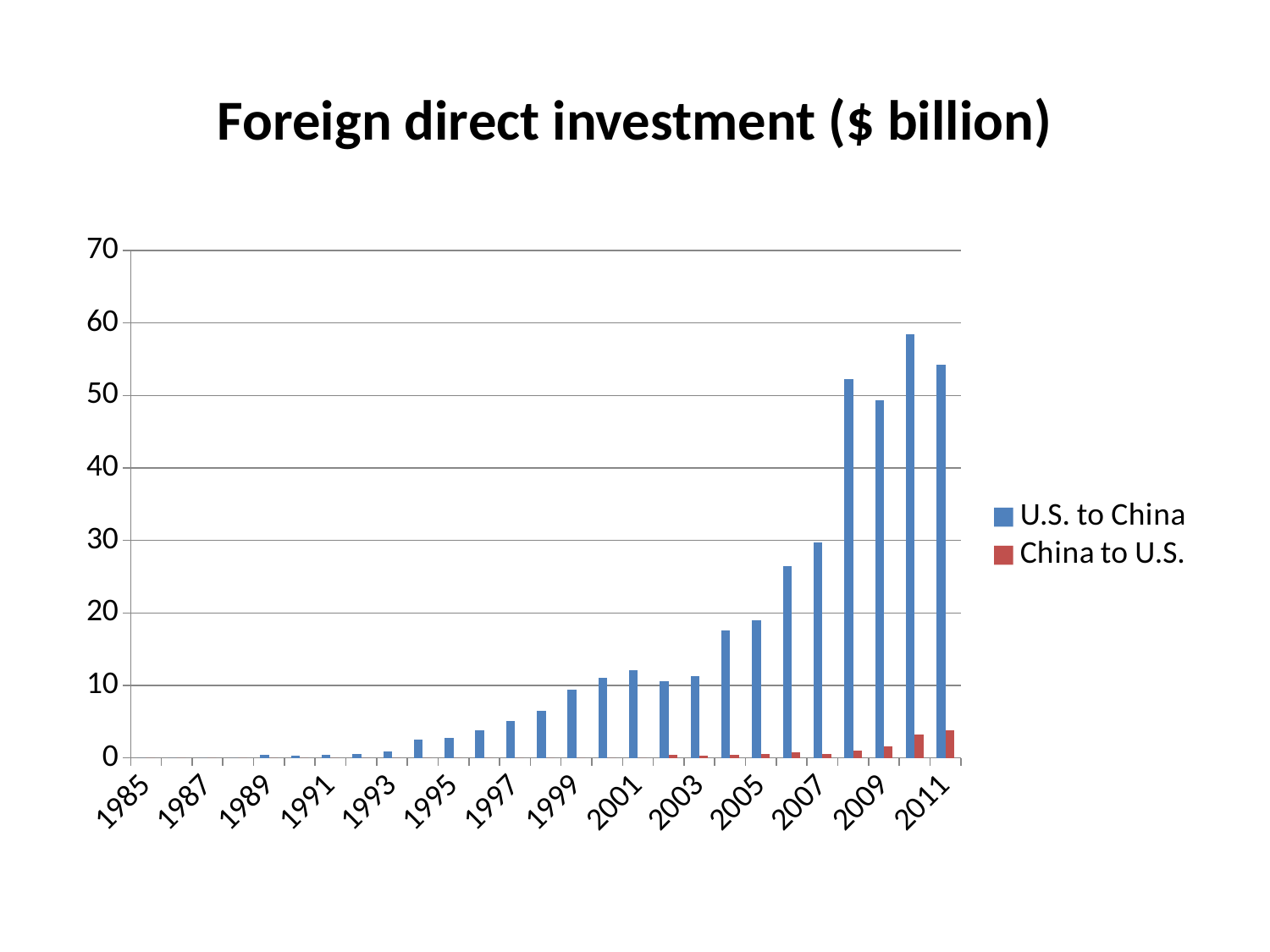
Is the U.S. to China value for 1997 greater or less than 10? less Is the U.S. to China value for 2011 greater or less than 50? greater What is the title of the chart? Foreign direct investment ($ billion) Is the China to U.S. value for 2011 greater or less than 10? less For the U.S. to China series, which year has the larger value, 2009 or 2011? 2011 Overall, do the U.S. to China values rise or fall from 1985 to 2011? rise In 2011, which series has the larger value, U.S. to China or China to U.S.? U.S. to China How many series does the legend list? 2 What kind of chart is shown on the slide? bar chart Which colour represents the U.S. to China series? blue